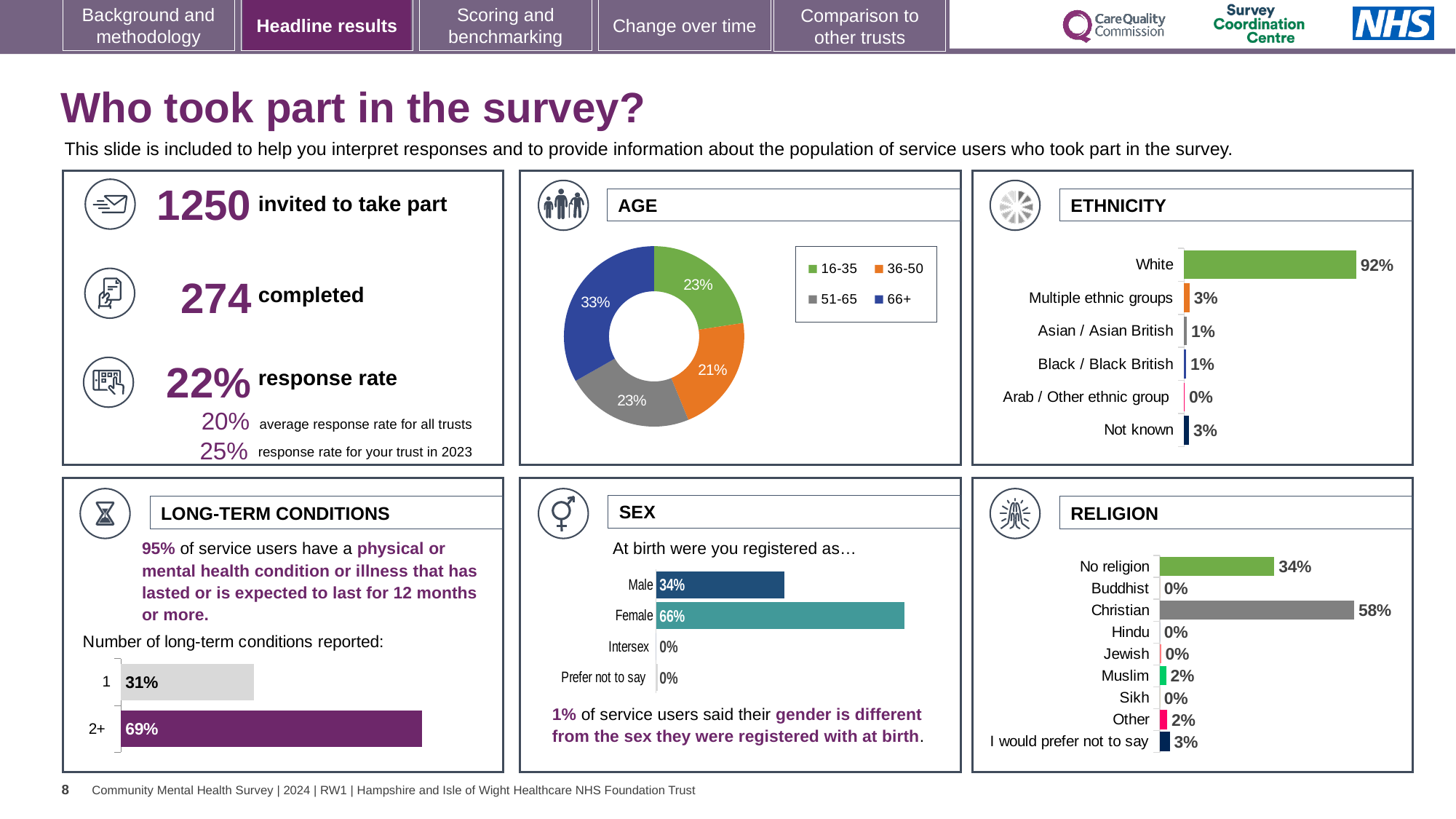
In the ETHNICITY chart, what is the value for White? 92% How many entries does the legend of the AGE chart list? 4 In the LONG-TERM CONDITIONS chart, what is the difference between the values for 2+ and 1 conditions? 38% How many categories are shown in the RELIGION chart? 9 In the AGE chart, what percentage of respondents were aged 66+? 33% In the ETHNICITY chart, which category has the lowest value? Arab / Other ethnic group In the RELIGION chart, which category has the highest value? Christian What kind of chart is the AGE chart? Donut (pie) chart In the SEX chart, what is the value for Male? 34% In the AGE chart, which age group has the largest share? 66+ How many categories are shown in the ETHNICITY chart? 6 In the SEX chart, which is larger, Male or Female? Female